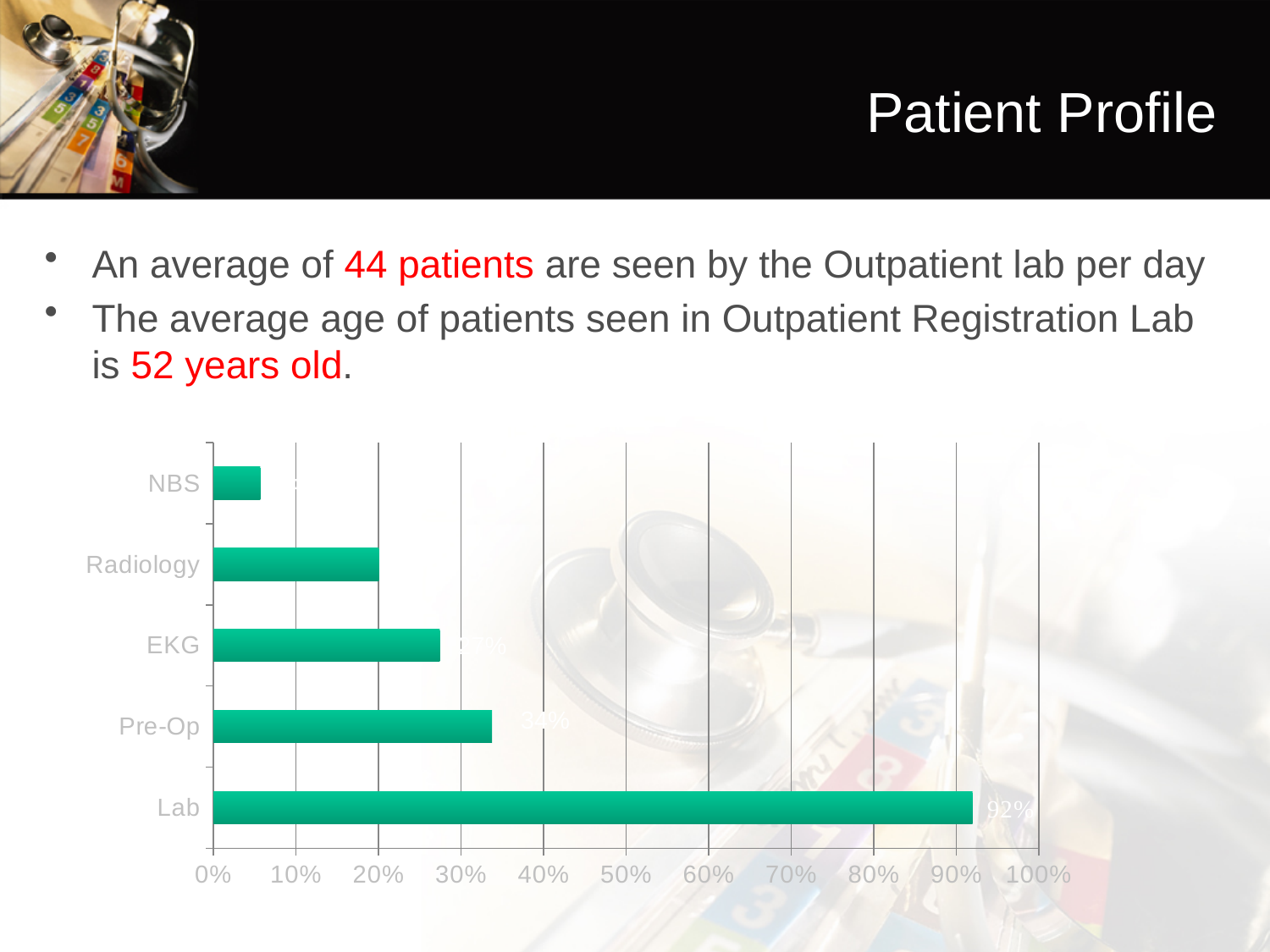
What is the value for Lab? 92% Is the value for Lab greater or less than 90%? greater What type of chart is shown on the slide? bar chart Which category has the lowest value? NBS What is the maximum value shown on the horizontal axis? 100% Is the value for NBS greater or less than 10%? less What is the value for Pre-Op? 34% How many categories are shown on the chart? 5 Is the value for EKG greater or less than 20%? greater Which is larger, the value for Radiology or the value for Pre-Op? Pre-Op What is the difference between the values for Lab and Pre-Op? 58% Which category has the highest value? Lab